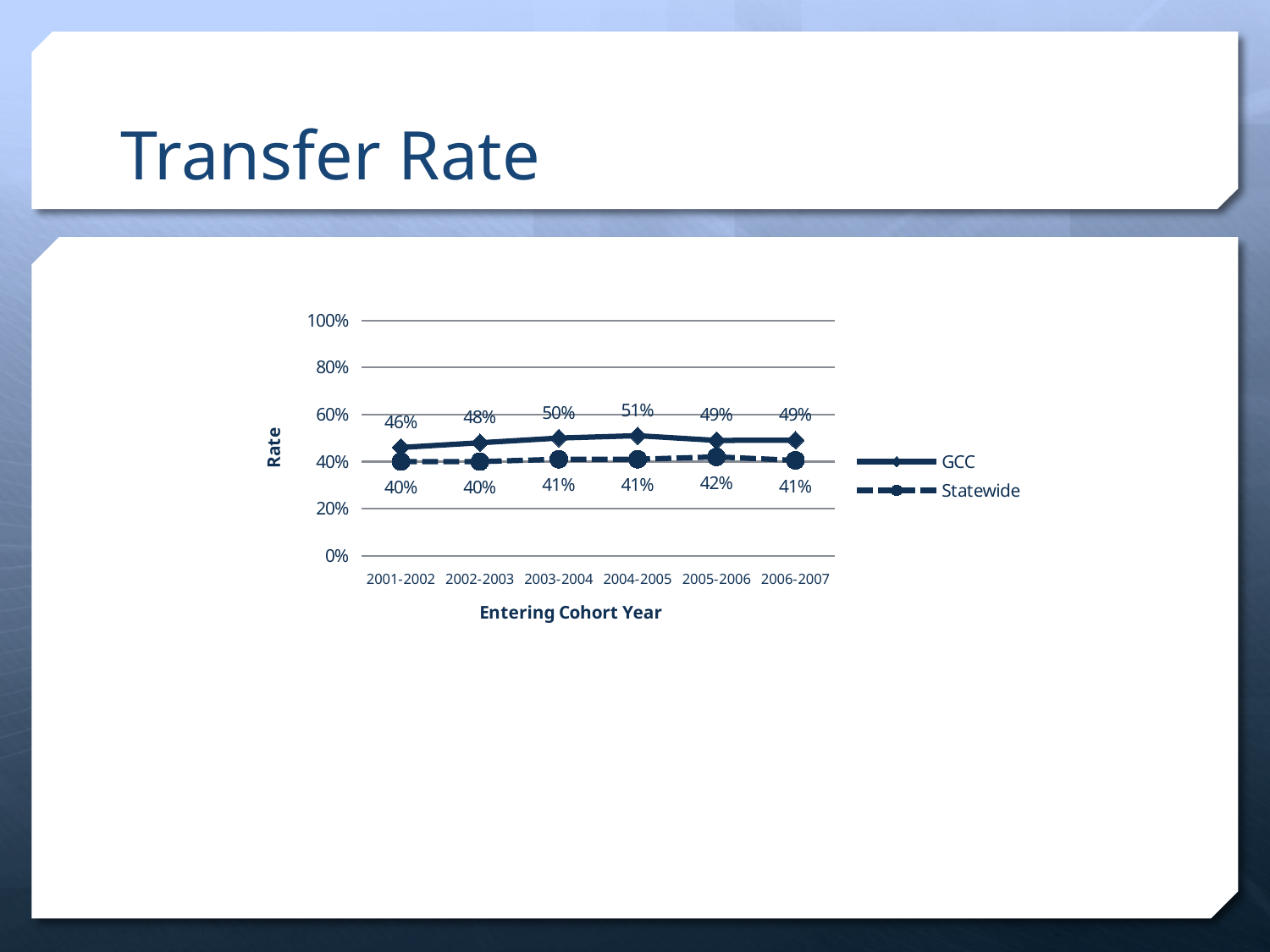
How many entering cohort years are shown on the x axis? 6 What is the difference between the GCC and Statewide transfer rates for the 2004-2005 cohort? 10% What is the Statewide transfer rate for the 2001-2002 entering cohort? 40% Which entering cohort year has the lowest GCC transfer rate? 2001-2002 What is the GCC transfer rate for the 2001-2002 entering cohort? 46% How many series does the legend list? 2 What kind of chart is shown on the slide? Line chart What is the label of the x axis? Entering Cohort Year What is the GCC transfer rate for the 2004-2005 entering cohort? 51% Which entering cohort year has the highest GCC transfer rate? 2004-2005 What is the Statewide transfer rate for the 2005-2006 entering cohort? 42% Which series has the higher transfer rate for the 2002-2003 cohort, GCC or Statewide? GCC